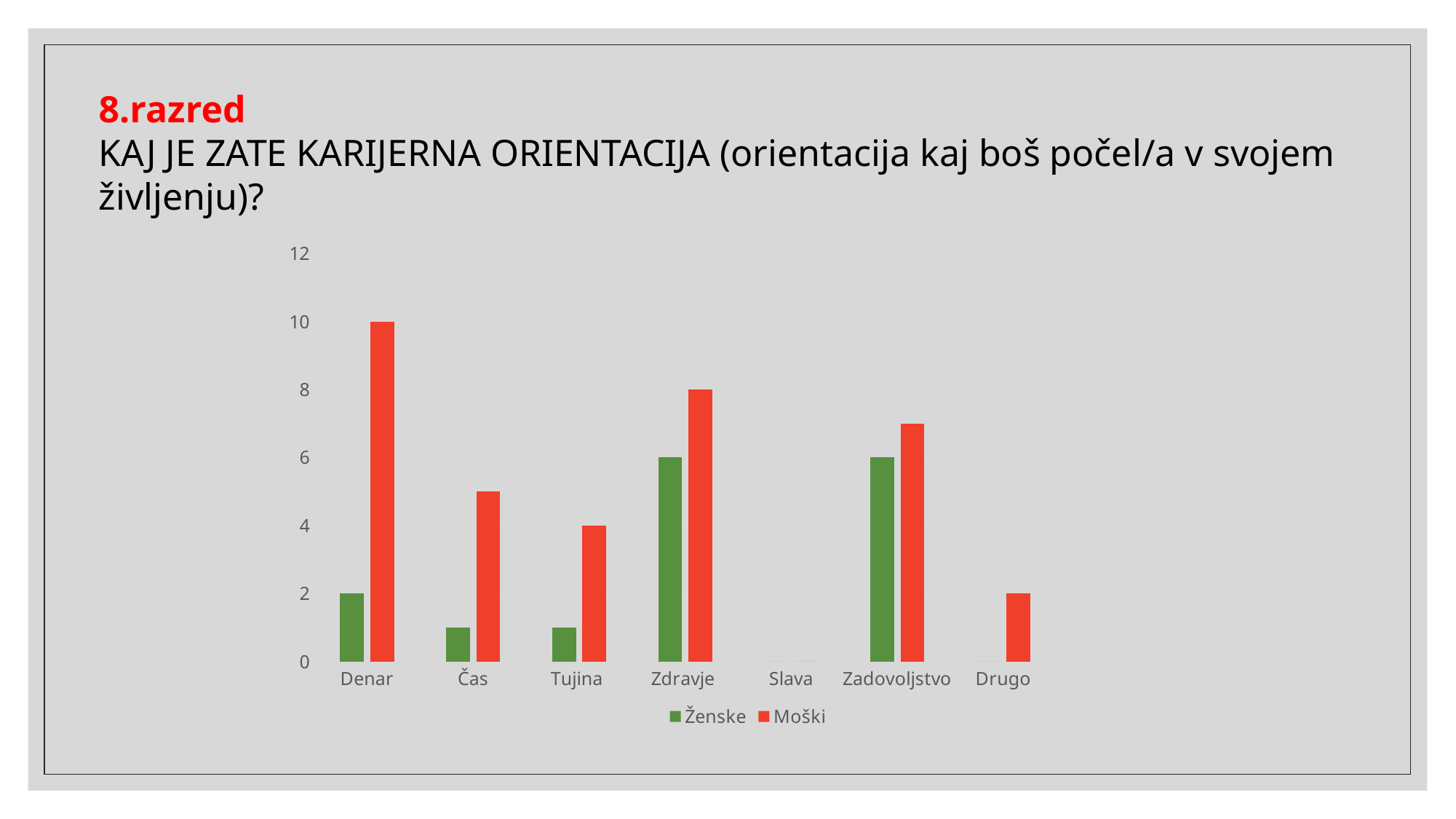
What is the difference between the Moški and Ženske values in the Denar category? 8 Which category has the lowest value for Moški? Slava What is the value for Ženske in the Denar category? 2 How many categories are shown on the x axis? 7 What kind of chart is shown on the slide? bar chart What is the value for Moški in the Zdravje category? 8 Which category has the highest value for Moški? Denar What is the value for Ženske in the Zadovoljstvo category? 6 How many series does the legend list? 2 In the Zdravje category, which series has the larger value, Ženske or Moški? Moški Is the value for Moški in the Čas category greater or less than 4? greater What is the value for Moški in the Denar category? 10